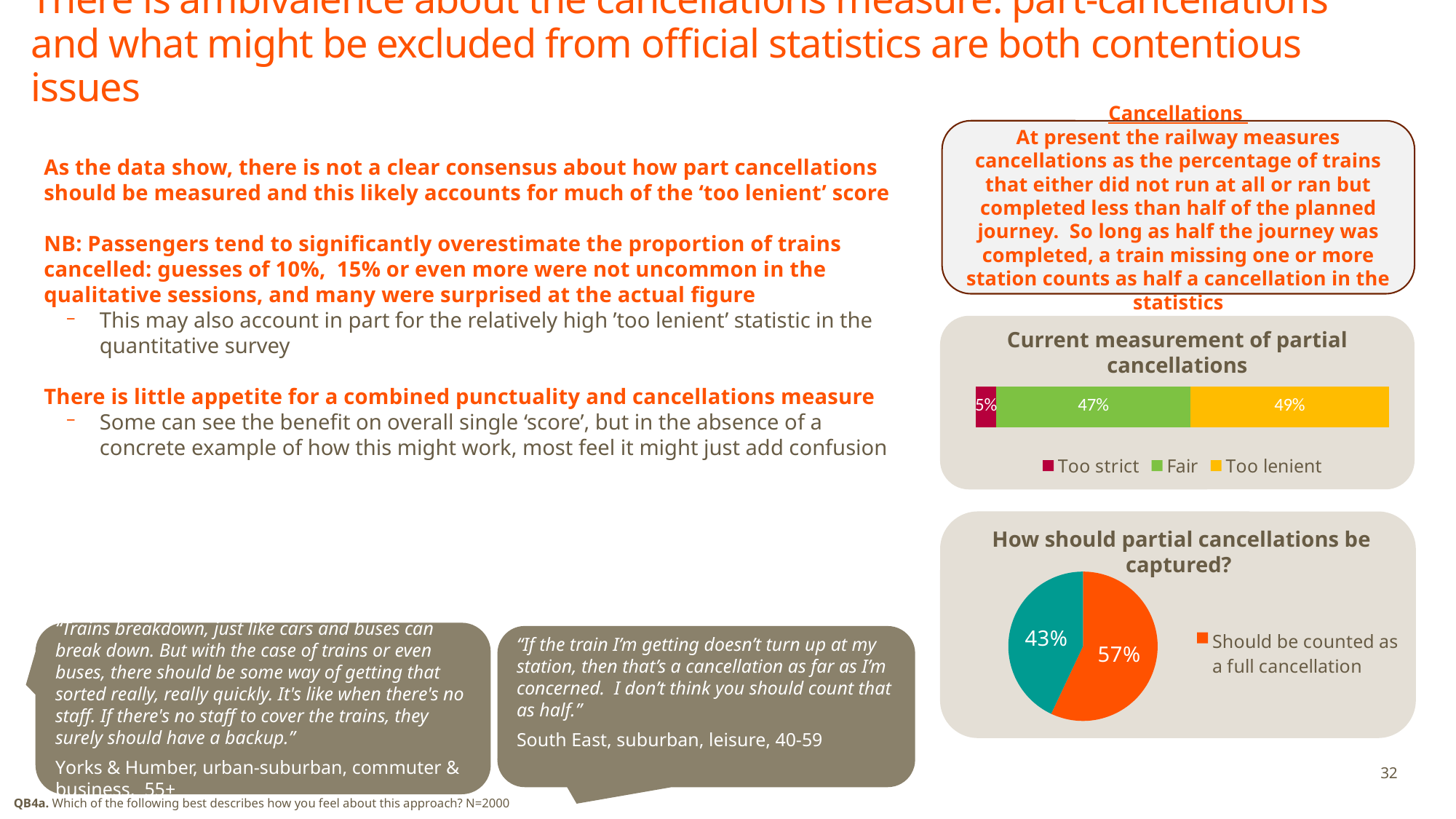
What type of chart is 'Current measurement of partial cancellations'? Stacked bar chart In the 'How should partial cancellations be captured?' chart, what percentage said partial cancellations 'Should be counted as a full cancellation'? 57% In the 'Current measurement of partial cancellations' chart, which response has the largest share? Too lenient In the 'Current measurement of partial cancellations' chart, what is the difference between the 'Too lenient' and 'Too strict' percentages? 44% In the 'Current measurement of partial cancellations' chart, what percentage said 'Too strict'? 5% In the 'How should partial cancellations be captured?' chart, what percentage is shown on the teal slice? 43% What type of chart is 'How should partial cancellations be captured?'? Pie chart In the 'Current measurement of partial cancellations' chart, which response has the smallest share? Too strict In the 'Current measurement of partial cancellations' chart, how many series does the legend list? 3 In the 'How should partial cancellations be captured?' chart, what colour is the 'Should be counted as a full cancellation' slice? Orange In the 'Current measurement of partial cancellations' chart, what percentage of respondents said the measurement is 'Fair'? 47% In the 'Current measurement of partial cancellations' chart, what percentage said 'Too lenient'? 49%